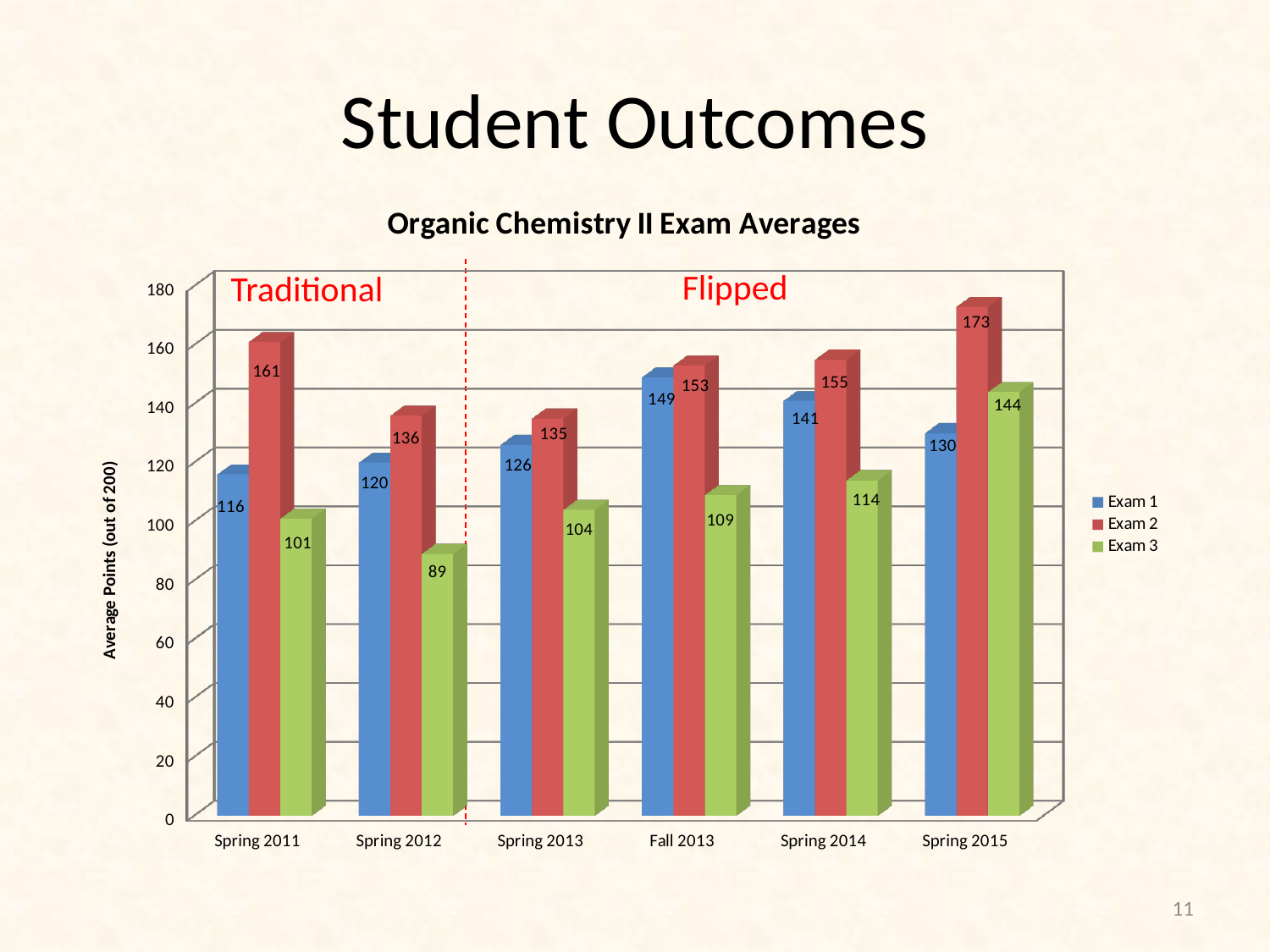
What is the difference between the Exam 3 averages for Spring 2015 and Spring 2012? 55 How many semesters are shown on the x axis? 6 What is the Exam 3 average for Spring 2012? 89 What is the Exam 1 average for Fall 2013? 149 Which semester has the lowest Exam 3 average? Spring 2012 What kind of chart is shown? Bar chart How many series does the legend list? 3 What is the label on the vertical axis? Average Points (out of 200) Which semester has the highest Exam 2 average? Spring 2015 What is the Exam 2 average for Spring 2015? 173 What is the title of the chart? Organic Chemistry II Exam Averages Which is larger, the Exam 1 average for Spring 2014 or for Spring 2015? Spring 2014